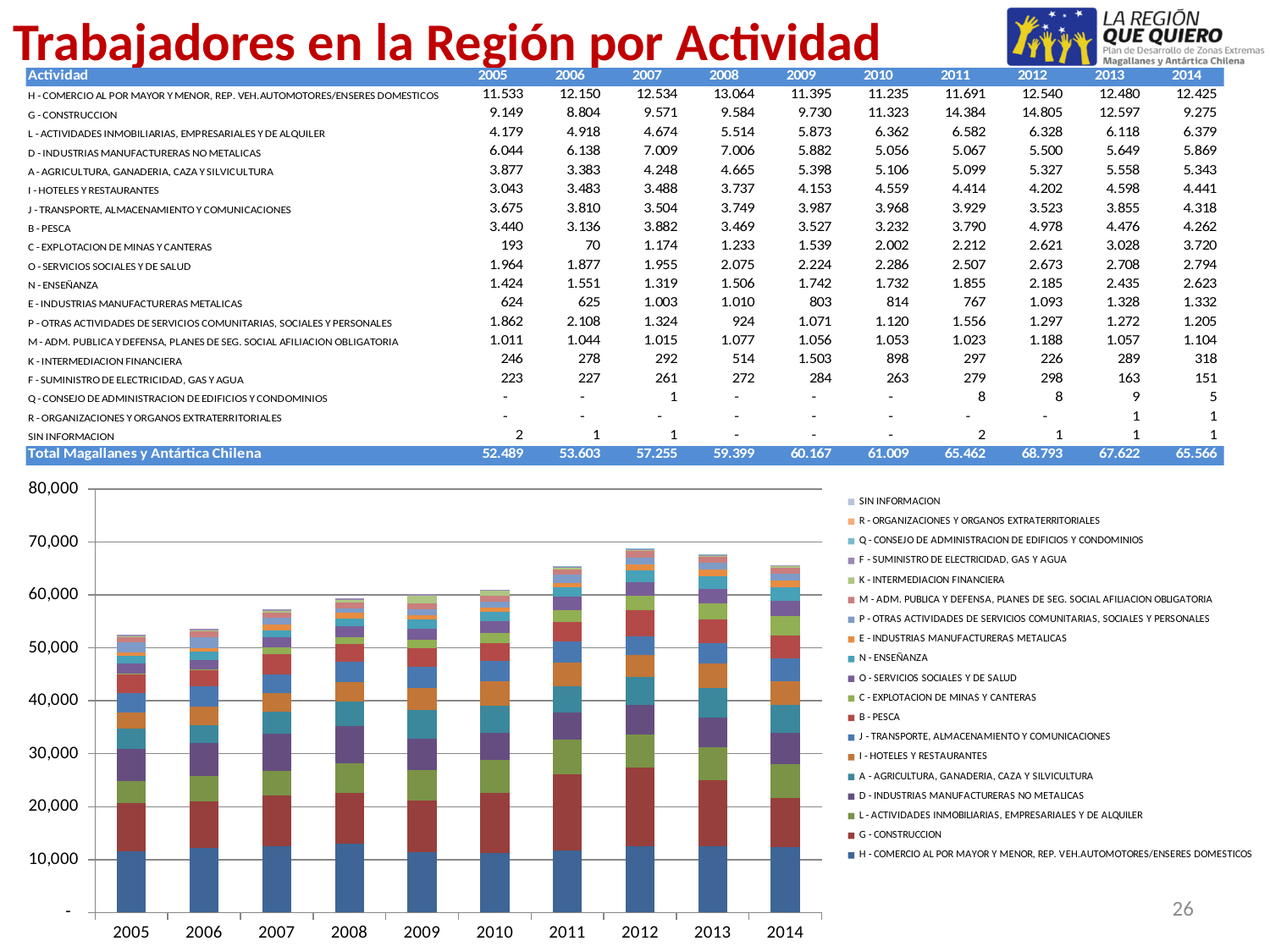
What is the total for Magallanes y Antártica Chilena in 2005? 52.489 Which series is shown as the bottom segment of each stacked bar? H - COMERCIO AL POR MAYOR Y MENOR, REP. VEH.AUTOMOTORES/ENSERES DOMESTICOS What is the total for Magallanes y Antártica Chilena in 2012? 68.793 Which year has the lowest total (Total Magallanes y Antártica Chilena)? 2005 Is the total stacked bar for 2014 greater or less than 60,000? greater How many years are shown along the x axis of the chart? 10 Which year has the highest total (Total Magallanes y Antártica Chilena)? 2012 What kind of chart is shown on the slide? stacked bar chart Which is larger, the total for 2007 or the total for 2010? 2010 What is the difference between the 2012 total and the 2005 total? 16.304 How many series does the chart legend list? 19 Is the total stacked bar for 2005 greater or less than 60,000? less